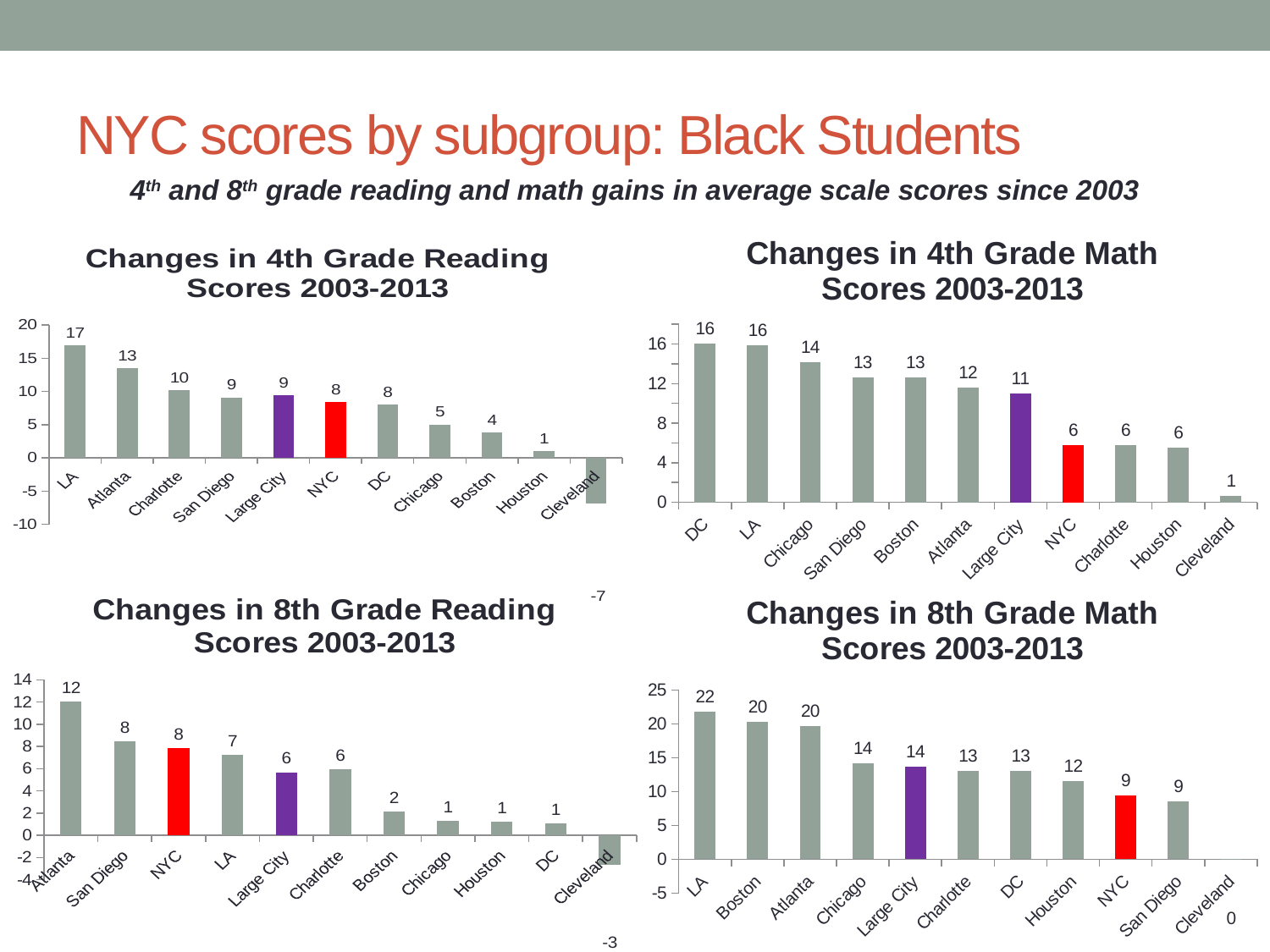
In the 'Changes in 4th Grade Reading Scores 2003-2013' chart, what is the value for NYC? 8 In the 'Changes in 8th Grade Reading Scores 2003-2013' chart, what is the value for Atlanta? 12 In the 'Changes in 4th Grade Reading Scores 2003-2013' chart, which city has the highest value? LA In the 'Changes in 8th Grade Reading Scores 2003-2013' chart, which is larger, the value for NYC or the value for Large City? NYC In the 'Changes in 8th Grade Math Scores 2003-2013' chart, what is the value for LA? 22 In the 'Changes in 4th Grade Math Scores 2003-2013' chart, how many cities are shown? 11 In the 'Changes in 8th Grade Math Scores 2003-2013' chart, what is the difference between Large City and NYC? 5 In the 'Changes in 4th Grade Math Scores 2003-2013' chart, which city has the lowest value? Cleveland In the 'Changes in 8th Grade Math Scores 2003-2013' chart, do the values rise or fall from left to right? fall In the 'Changes in 4th Grade Math Scores 2003-2013' chart, what is the value for Large City? 11 In the 'Changes in 4th Grade Reading Scores 2003-2013' chart, what is the difference between LA and Atlanta? 4 What type of chart is 'Changes in 8th Grade Math Scores 2003-2013'? bar chart